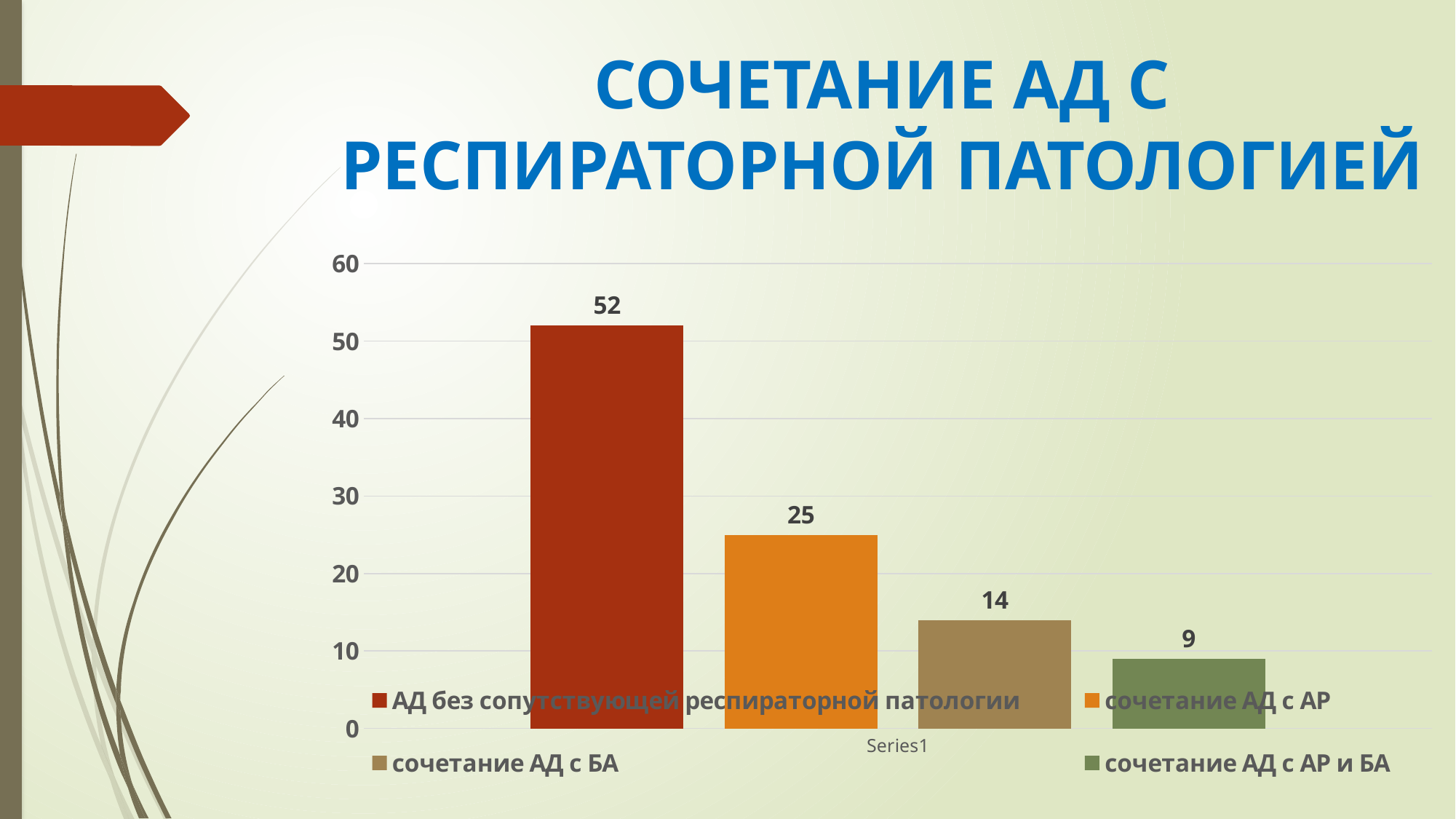
What is the value for "сочетание АД с БА"? 14 What is the value for "сочетание АД с АР и БА"? 9 How many bars are plotted on the chart? 4 Is the value for "сочетание АД с АР" greater or less than 30? less Which category has the highest value? АД без сопутствующей респираторной патологии What kind of chart is shown on the slide? bar chart Which category has the lowest value? сочетание АД с АР и БА What is the value for "сочетание АД с АР"? 25 What is the title of the slide? СОЧЕТАНИЕ АД С РЕСПИРАТОРНОЙ ПАТОЛОГИЕЙ Which is larger: the value for "сочетание АД с БА" or "сочетание АД с АР и БА"? сочетание АД с БА What is the difference between the values for "АД без сопутствующей респираторной патологии" and "сочетание АД с АР"? 27 What is the value for "АД без сопутствующей респираторной патологии"? 52